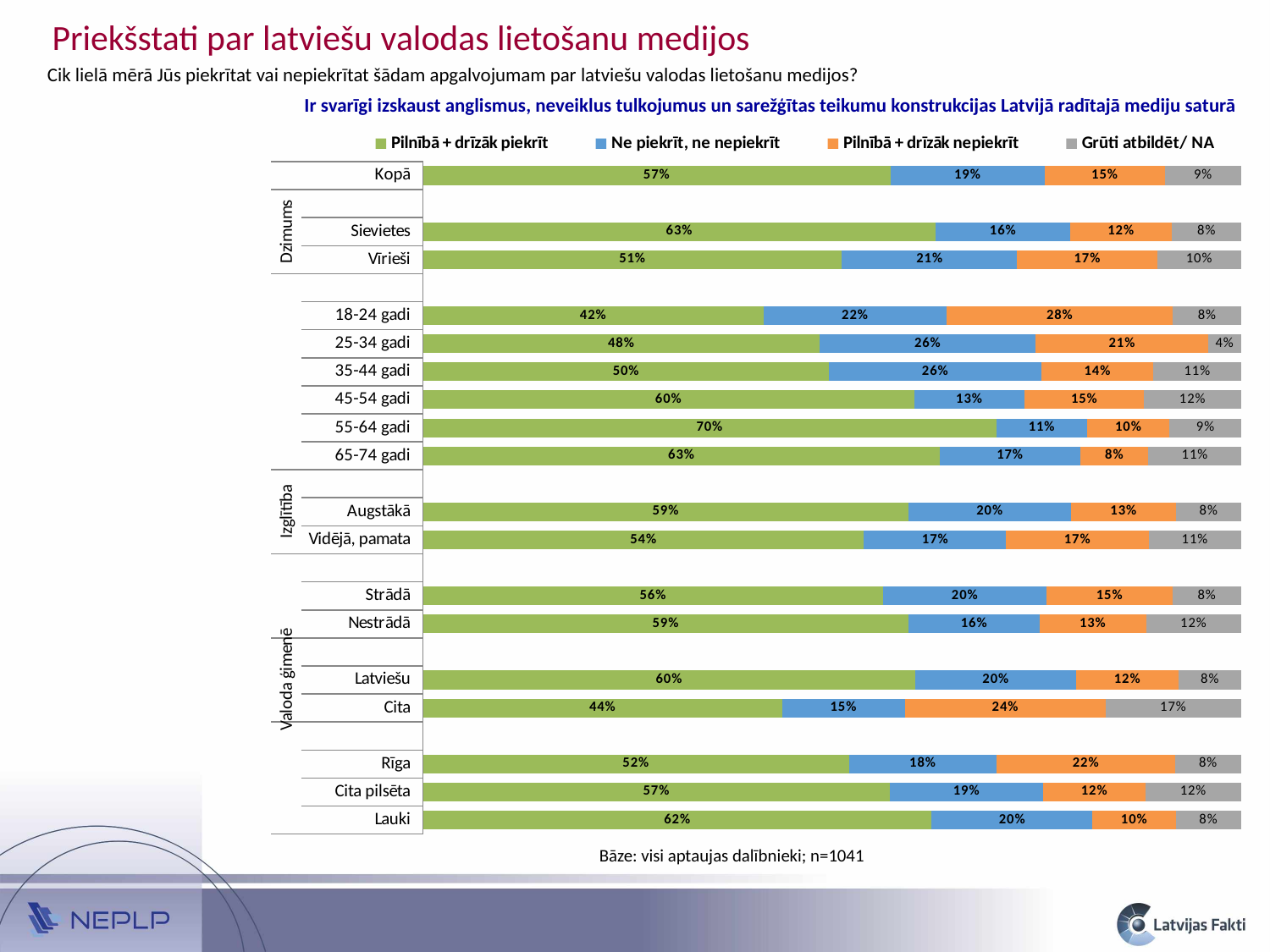
How many categories (rows) are plotted in the chart? 18 How many series does the legend list? 4 What is the value of "Pilnībā + drīzāk nepiekrīt" for Cita (Valoda ģimenē)? 24% Which has a larger "Pilnībā + drīzāk nepiekrīt" value, Rīga or Lauki? Rīga Which category has the lowest value for "Pilnībā + drīzāk piekrīt"? 18-24 gadi What is the value of "Grūti atbildēt/ NA" for Lauki? 8% What kind of chart is shown on the slide? Stacked bar chart What is the difference between the "Pilnībā + drīzāk piekrīt" values for Sievietes and Vīrieši? 12% What is the total of the stacked bar for Kopā? 100% What is the value of "Pilnībā + drīzāk piekrīt" for Kopā? 57% What is the value of "Ne piekrīt, ne nepiekrīt" for 25-34 gadi? 26% Which category has the highest value for "Pilnībā + drīzāk piekrīt"? 55-64 gadi